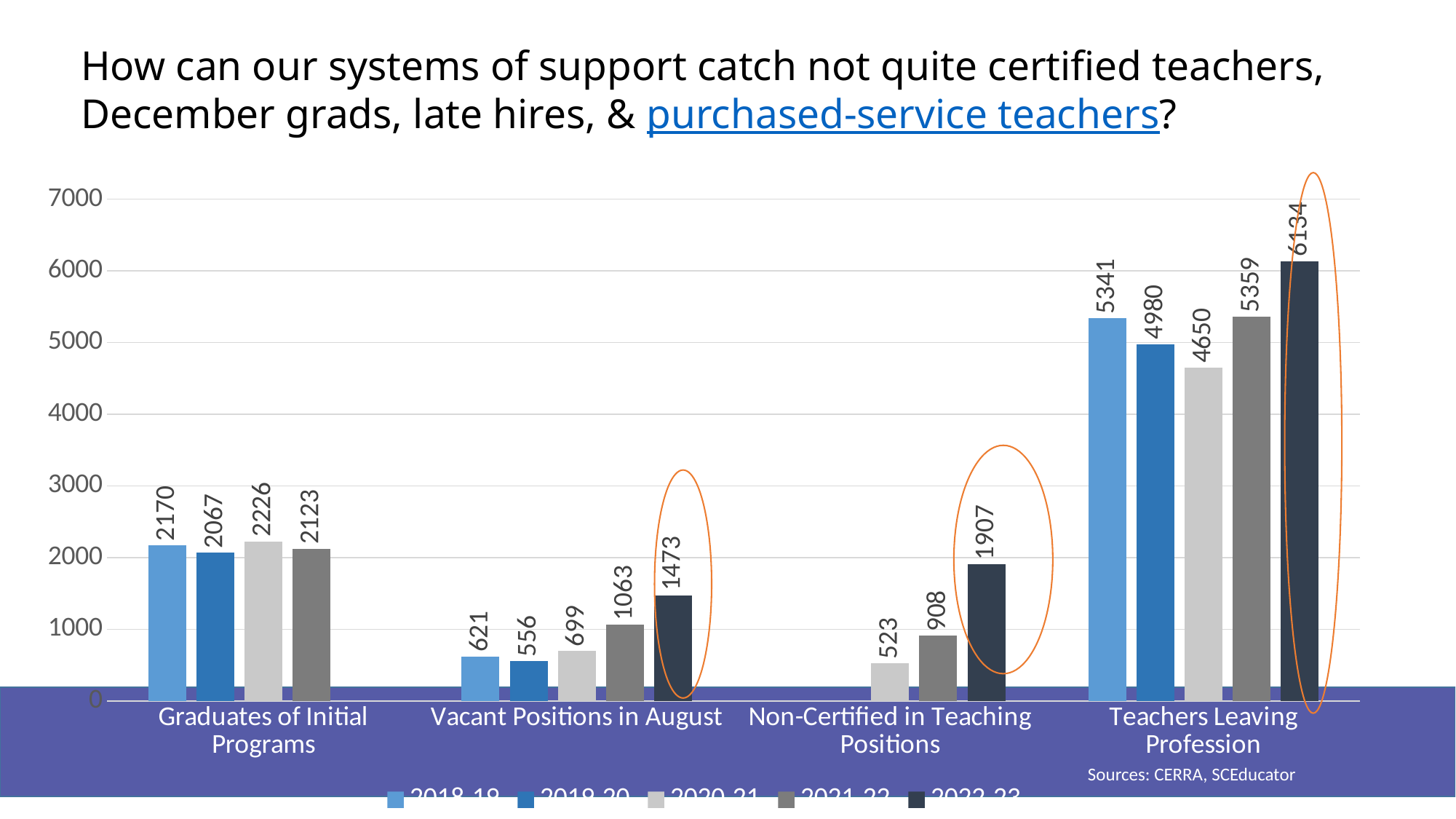
What is the lowest value among the bars in the Graduates of Initial Programs category? 2067 Which bar is the highest in the Teachers Leaving Profession category? the darkest (rightmost) bar, 6134 What kind of chart is shown on the slide? bar chart In the Teachers Leaving Profession category, which is larger: the medium blue bar or the light grey bar? the medium blue bar (4980) What is the value of the light grey bar in the Vacant Positions in August category? 699 In the Non-Certified in Teaching Positions category, what is the difference between the darkest bar and the medium grey bar? 999 How many series does the legend list? 5 How many bars are shown in the Non-Certified in Teaching Positions category? 3 What is the difference between the two rightmost bars (1473 and 1063) in the Vacant Positions in August category? 410 What is the value of the first (light blue) bar in the Graduates of Initial Programs category? 2170 How many categories are shown along the x axis? 4 What is the value of the darkest (rightmost) bar in the Teachers Leaving Profession category? 6134